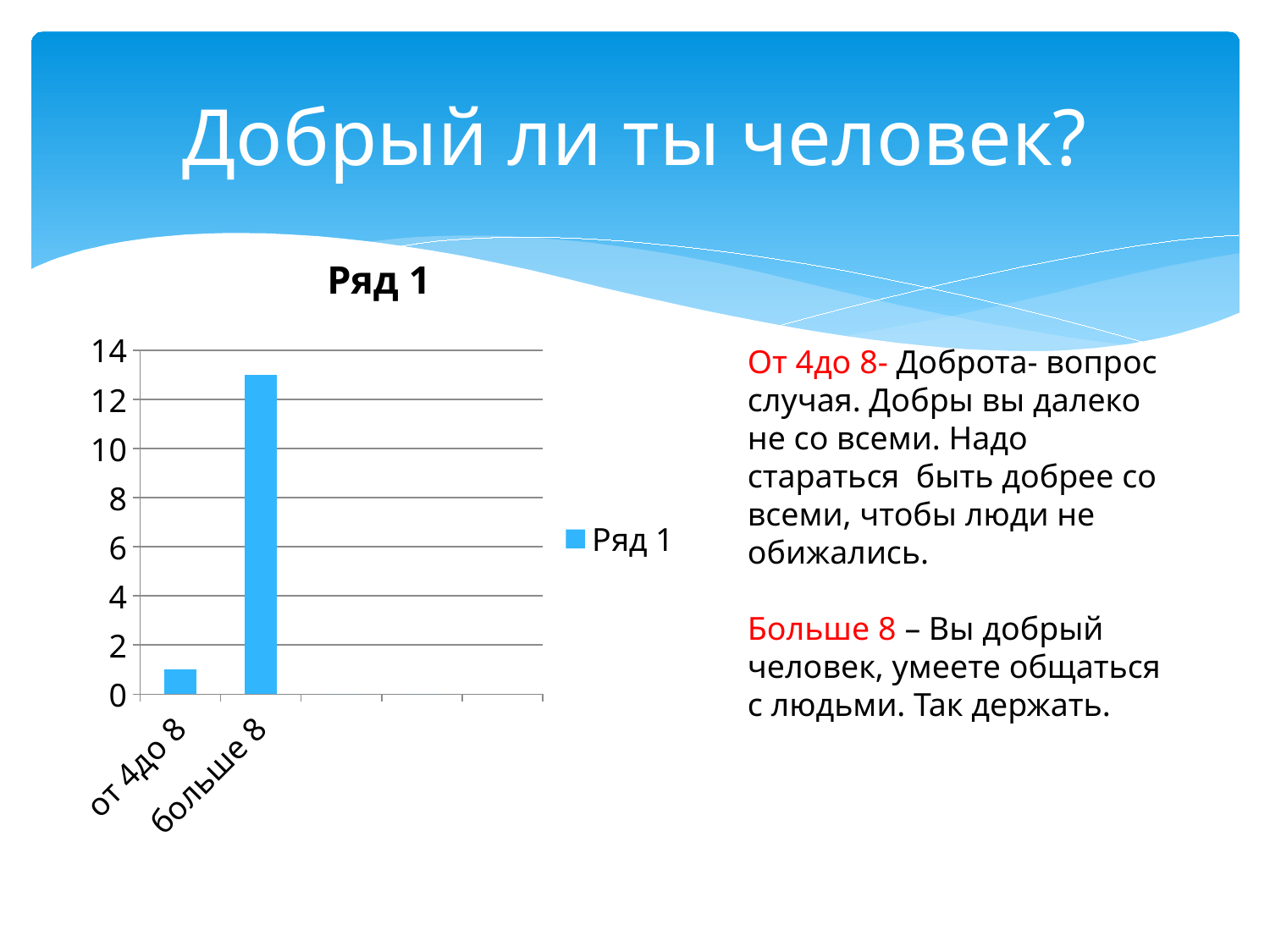
What is the name of the series shown in the legend? Ряд 1 Which category has the lowest bar? от 4до 8 Which category has the highest bar? больше 8 How many series does the chart legend list? 1 Is the value for "больше 8" greater or less than 12? greater Do the bar values rise or fall from "от 4до 8" to "больше 8"? rise Which is larger, the value for "от 4до 8" or the value for "больше 8"? больше 8 Is the value for "больше 8" greater or less than 14? less What is the title of the chart? Ряд 1 Is the value for "от 4до 8" greater or less than 2? less What kind of chart is shown on the slide? bar chart How many bars are plotted in the chart? 2